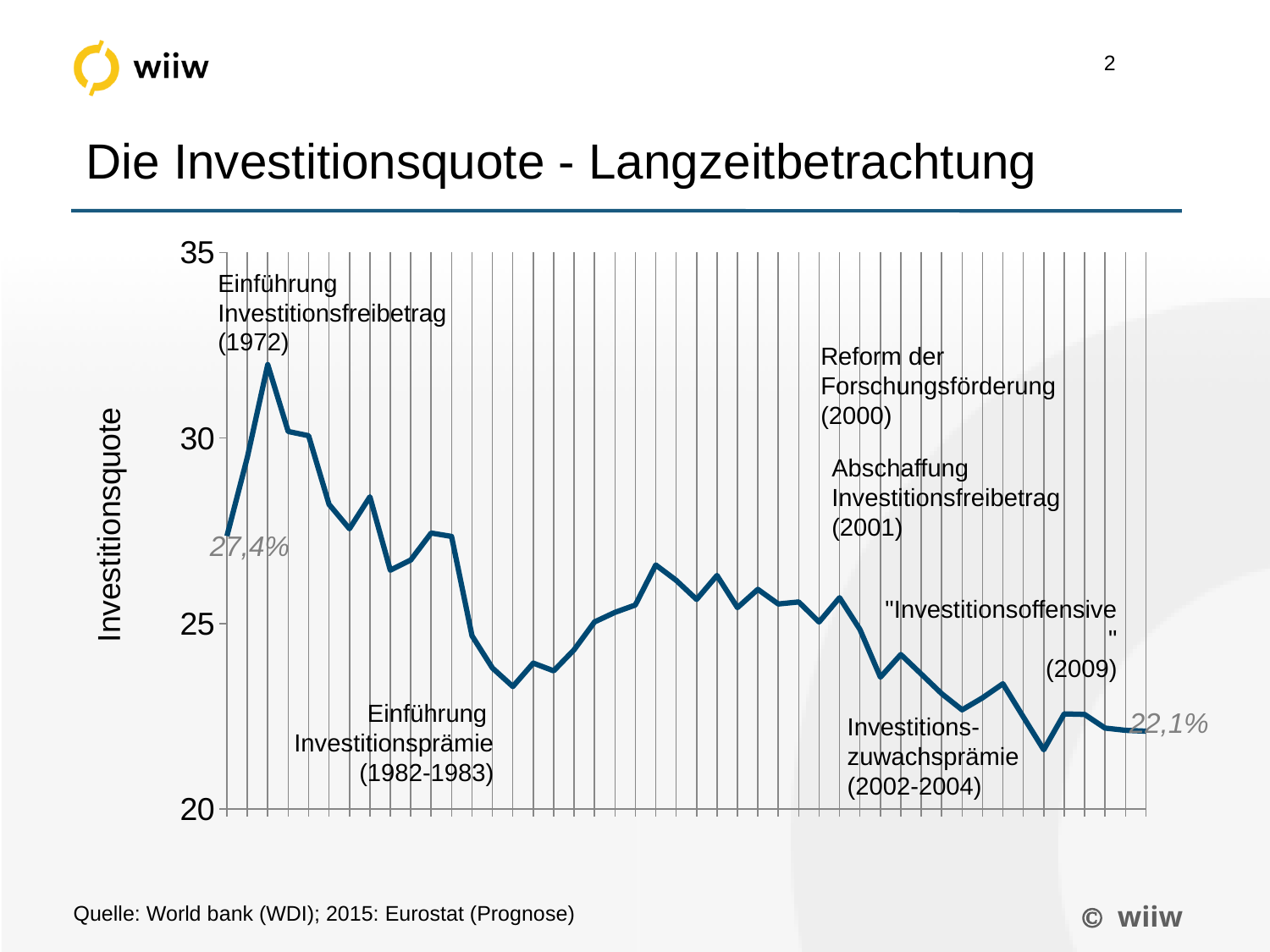
What is the label on the vertical axis of the chart? Investitionsquote What is the value labelled at the end (right end) of the line? 22,1% What is the title of the slide containing the chart? Die Investitionsquote - Langzeitbetrachtung Is the highest point of the line greater or less than 30? greater What kind of chart is shown on the slide? line chart Overall, does the Investitionsquote rise or fall from the left end of the chart to the right end? fall What is the value labelled at the start (left end) of the line? 27,4% How many data series are plotted in the chart? 1 Is the highest point of the line greater or less than 35? less By how many percentage points does the labelled end value (22,1%) differ from the labelled start value (27,4%)? 5,3 Is the lowest point of the line greater or less than 25? less Which is larger, the labelled value at the start of the line or the labelled value at the end of the line? the start value (27,4%)